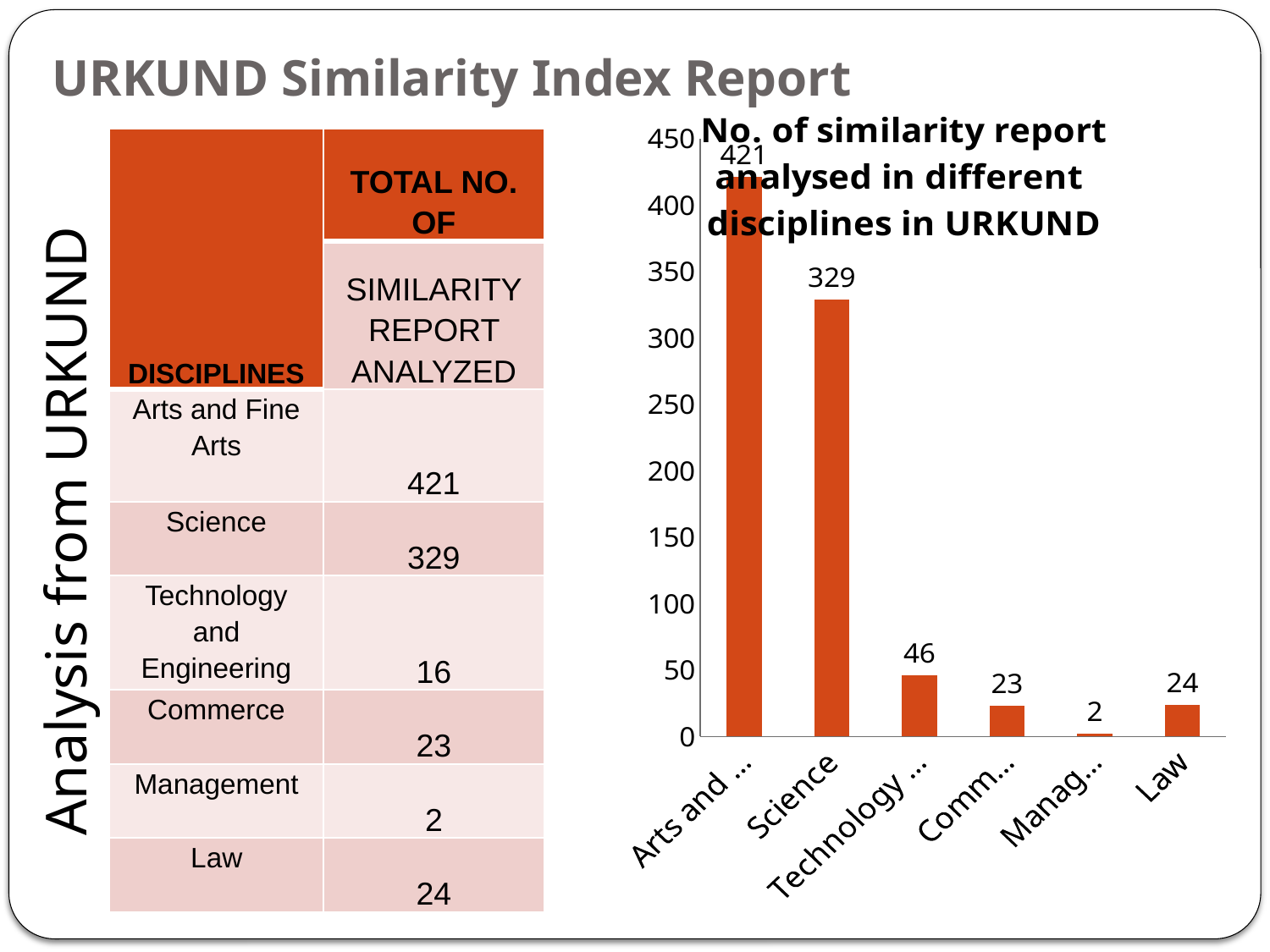
Which discipline has the highest number of similarity reports analysed in the chart? Arts and Fine Arts What is the title of the chart? No. of similarity report analysed in different disciplines in URKUND Which has a larger value in the chart, Science or Law? Science What type of chart is shown on the slide? bar chart What is the value shown for Law in the chart? 24 How many disciplines (bars) are plotted in the chart? 6 What is the value shown for Science in the chart? 329 What is the difference between the values for Arts and Fine Arts and Science in the chart? 92 Which discipline has the lowest number of similarity reports analysed in the chart? Management Is the value for Science in the chart greater or less than 300? greater What is the value shown for Management in the chart? 2 What is the value shown for Commerce in the chart? 23